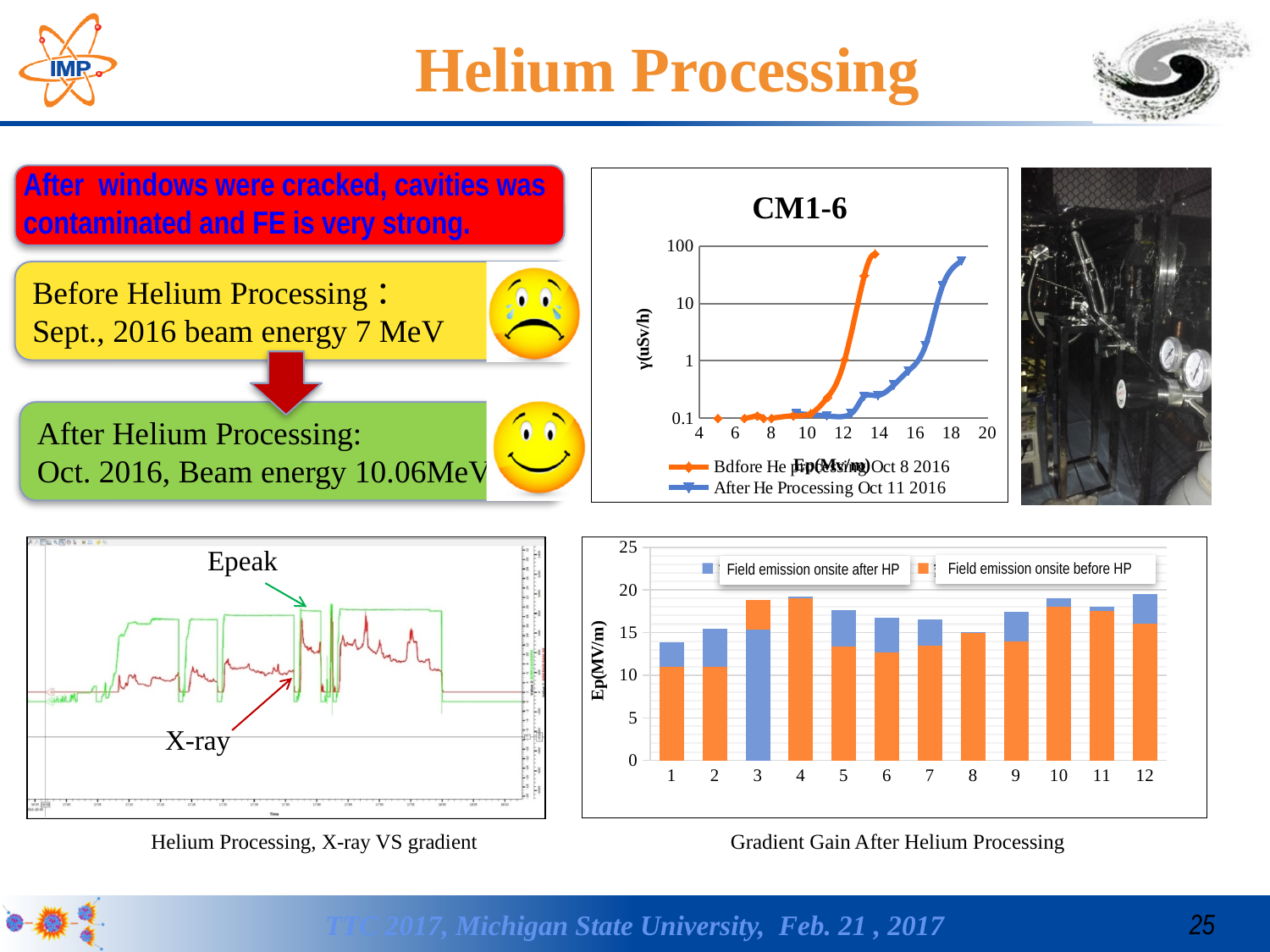
In the Gradient Gain After Helium Processing chart, is the Field emission onsite before HP value for cavity 1 greater or less than 15 MV/m? less In the CM1-6 chart, is the After He Processing Oct 11 2016 value at Ep = 16 MV/m greater or less than 1 uSv/h? less In the Gradient Gain After Helium Processing chart, which cavity has the larger Field emission onsite before HP value: cavity 1 or cavity 10? cavity 10 How many series does the legend of the CM1-6 chart list? 2 What kind of chart is the Gradient Gain After Helium Processing chart? bar chart How many series does the legend of the Gradient Gain After Helium Processing chart list? 2 What kind of chart is the CM1-6 chart? line chart In the CM1-6 chart, is the Before He processing Oct 8 2016 value at Ep = 13 MV/m greater or less than 10 uSv/h? greater In the Gradient Gain After Helium Processing chart, which colour represents Field emission onsite after HP? blue In the CM1-6 chart, at Ep = 14 MV/m, which series has the higher γ value: Before He processing Oct 8 2016 or After He Processing Oct 11 2016? Before He processing Oct 8 2016 How many cavities (categories) are shown on the x axis of the Gradient Gain After Helium Processing chart? 12 In the CM1-6 chart, do the γ(uSv/h) values rise or fall as Ep(MV/m) increases? rise